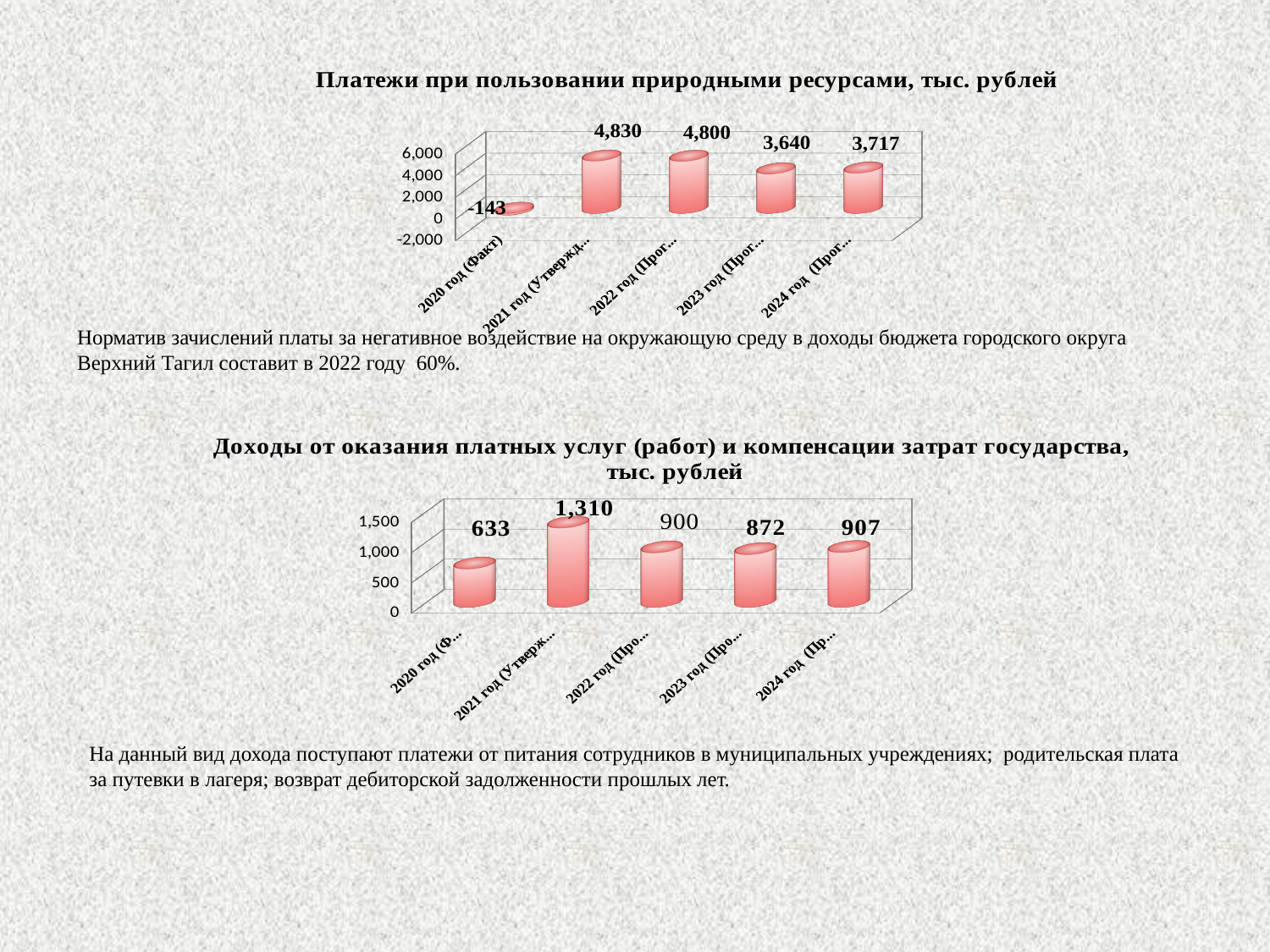
In the bottom chart (Доходы от оказания платных услуг), what is the value for 2022 год? 900 In the bottom chart (Доходы от оказания платных услуг), which year has the lowest value? 2020 год In the top chart (Платежи при пользовании природными ресурсами), what is the value for 2023 год? 3,640 In the bottom chart (Доходы от оказания платных услуг), what is the difference between the values for 2021 год and 2020 год? 677 In the top chart (Платежи при пользовании природными ресурсами), what is the difference between the values for 2021 год and 2022 год? 30 In the top chart (Платежи при пользовании природными ресурсами), which year has the highest value? 2021 год What type of chart is the bottom chart (Доходы от оказания платных услуг)? Bar chart In the top chart (Платежи при пользовании природными ресурсами), which year has the lowest value? 2020 год (Факт) In the top chart (Платежи при пользовании природными ресурсами), what is the value for 2020 год (Факт)? -143 In the top chart (Платежи при пользовании природными ресурсами), how many bars are plotted? 5 In the bottom chart (Доходы от оказания платных услуг), which is larger, the value for 2023 год or 2024 год? 2024 год In the bottom chart (Доходы от оказания платных услуг), what is the value for 2021 год? 1,310